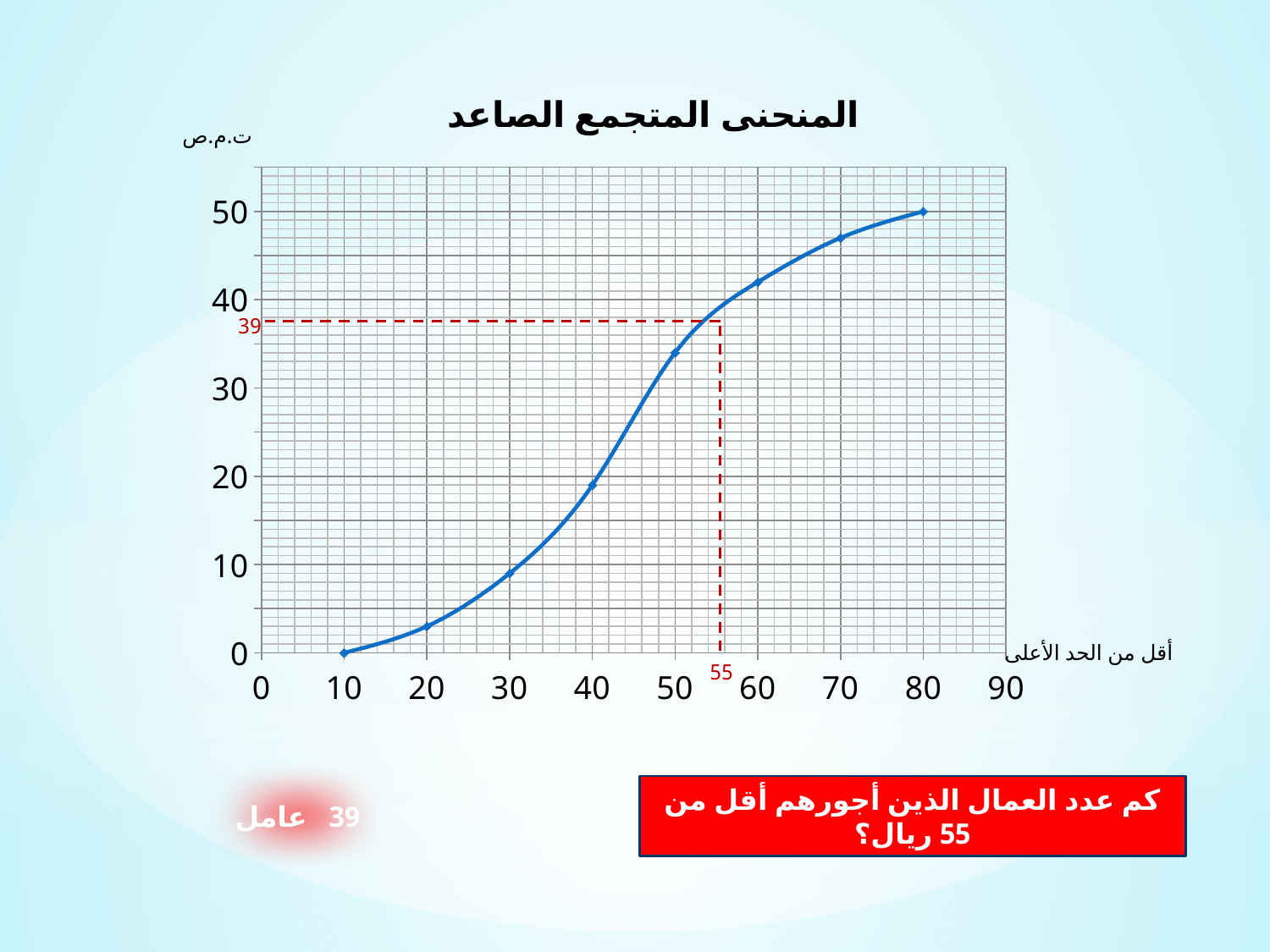
Is the value of the curve at x = 50 greater or less than 30? greater What is the difference between the value at x = 80 and the value at x = 55? 11 According to the dashed reference lines, what is the cumulative frequency at x = 55? 39 What kind of chart is shown on the slide? line chart What is the cumulative frequency value at x = 80? 50 What is the title of the chart? المنحنى المتجمع الصاعد What is the cumulative frequency value at x = 10? 0 Is the value of the curve at x = 20 greater or less than 10? less At which x value does the curve reach its highest point? 80 Is the value of the curve at x = 70 greater or less than 40? greater How many data points are plotted on the curve? 8 Do the values rise or fall as x increases along the x axis? rise